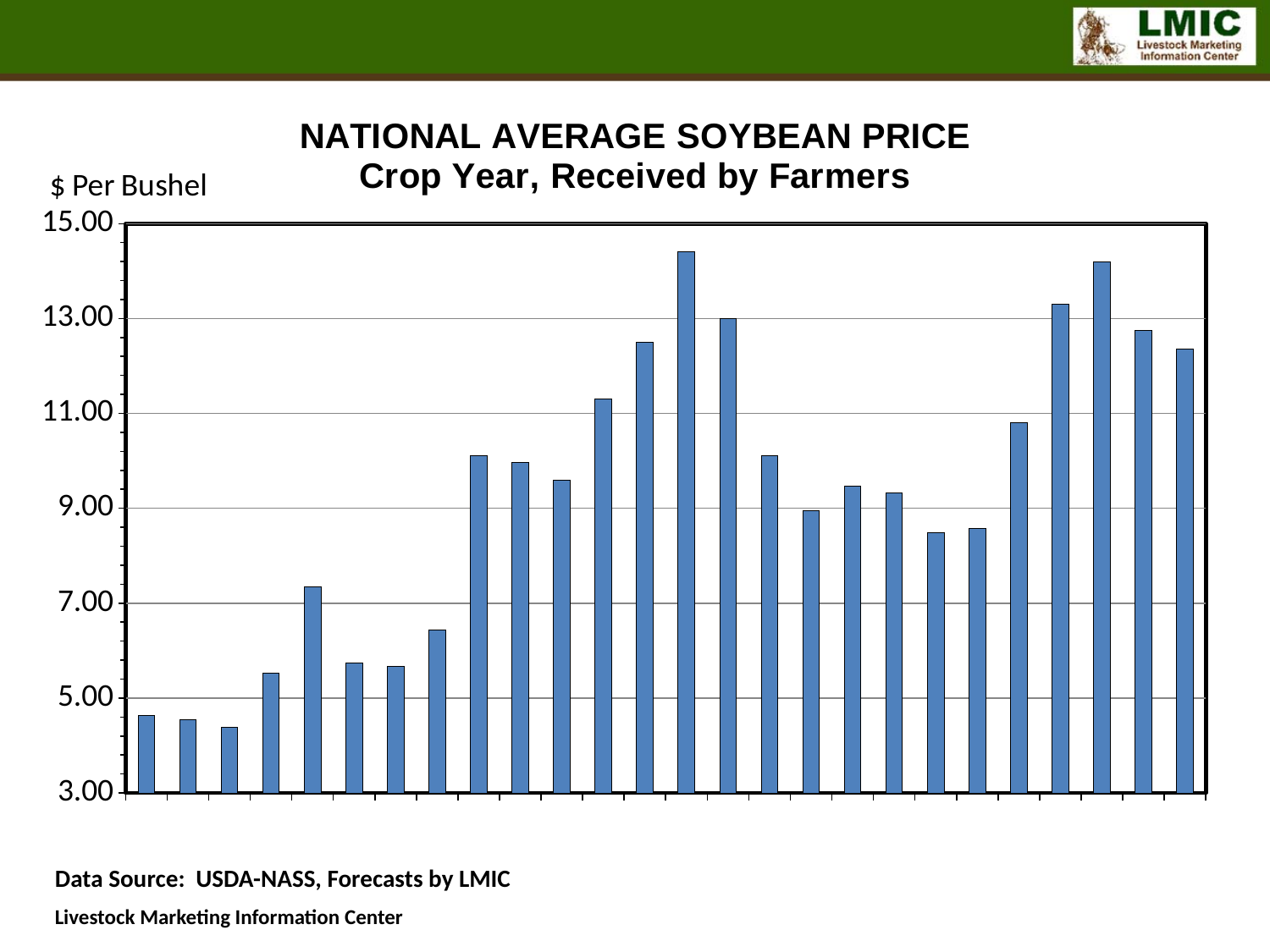
Which is larger, the fourth bar from the left or the fifth bar from the left? the fifth bar from the left How many bars are plotted in the chart? 26 What unit label is shown on the vertical axis of the chart? $ Per Bushel Is the value of the rightmost bar greater or less than 11.00? greater Overall, do the bar values rise or fall from left to right across the chart? rise What is the title of the chart? NATIONAL AVERAGE SOYBEAN PRICE Crop Year, Received by Farmers Is the value of the tallest bar greater or less than 13.00? greater What kind of chart is shown on the slide? bar chart Is the value of the third bar from the left greater or less than 5.00? less What is the highest tick value shown on the vertical axis? 15.00 Which is larger, the leftmost bar or the rightmost bar? the rightmost bar